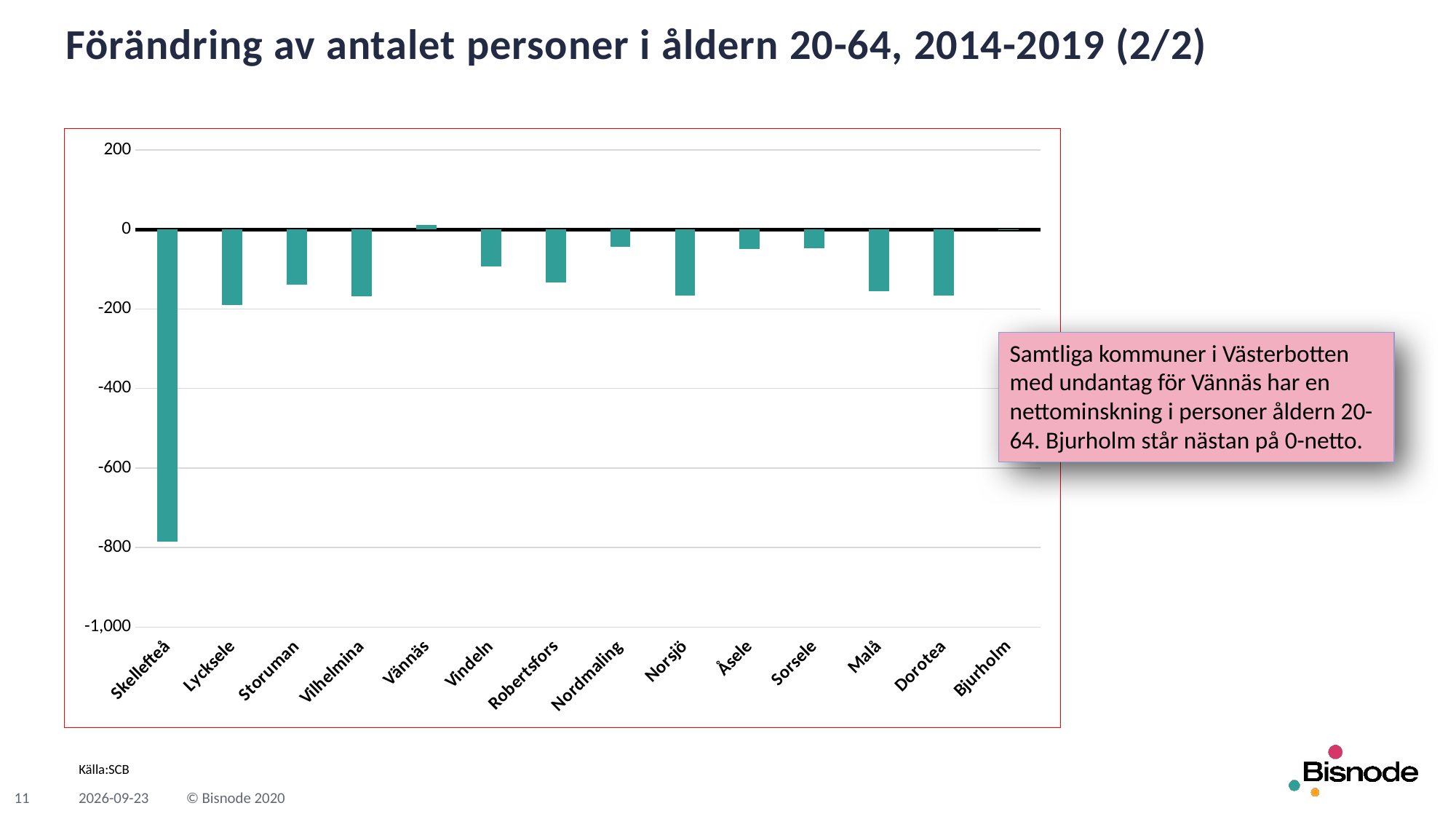
Which municipality has the highest value in the chart? Vännäs Is the value for Vindeln greater or less than -200? greater How many municipalities are shown on the x axis of the chart? 14 What is the title of the slide containing the chart? Förändring av antalet personer i åldern 20-64, 2014-2019 (2/2) What kind of chart is shown on the slide? bar chart Which municipality has the lowest value in the chart? Skellefteå Which has the larger value, Skellefteå or Lycksele? Lycksele Which has the larger value, Storuman or Vilhelmina? Storuman Is the value for Nordmaling greater or less than -200? greater Is the value for Storuman greater or less than -200? greater Which has the larger value, Vindeln or Nordmaling? Nordmaling